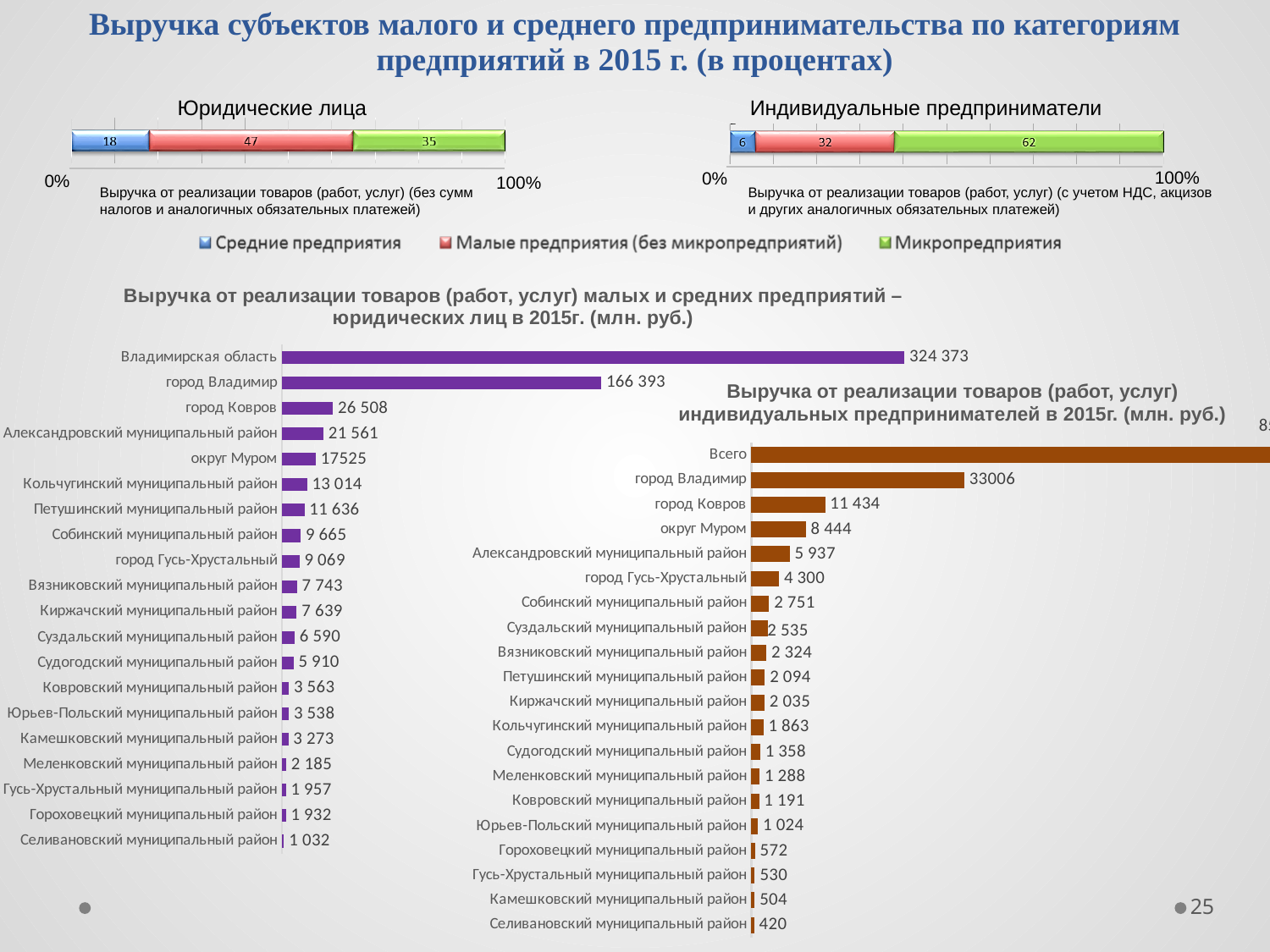
In the chart 'Выручка от реализации товаров (работ, услуг) индивидуальных предпринимателей в 2015г. (млн. руб.)', which is larger: Собинский муниципальный район or Петушинский муниципальный район? Собинский муниципальный район How many series does the shared legend of the two stacked bar charts list? 3 In the 'Юридические лица' stacked bar chart, what is the value for Малые предприятия (без микропредприятий)? 47 In the chart 'Выручка от реализации товаров (работ, услуг) малых и средних предприятий – юридических лиц в 2015г. (млн. руб.)', what is the value for город Владимир? 166 393 In the chart 'Выручка от реализации товаров (работ, услуг) малых и средних предприятий – юридических лиц в 2015г. (млн. руб.)', which category has the lowest value? Селивановский муниципальный район In the chart 'Выручка от реализации товаров (работ, услуг) малых и средних предприятий – юридических лиц в 2015г. (млн. руб.)', what is the difference between город Ковров and Александровский муниципальный район? 4 947 In the chart 'Выручка от реализации товаров (работ, услуг) индивидуальных предпринимателей в 2015г. (млн. руб.)', what is the value for Селивановский муниципальный район? 420 In the 'Индивидуальные предприниматели' stacked bar chart, what is the value for Микропредприятия? 62 What kind of chart is 'Выручка от реализации товаров (работ, услуг) индивидуальных предпринимателей в 2015г. (млн. руб.)'? Bar chart In the chart 'Выручка от реализации товаров (работ, услуг) индивидуальных предпринимателей в 2015г. (млн. руб.)', what is the value for город Ковров? 11 434 In the chart 'Выручка от реализации товаров (работ, услуг) малых и средних предприятий – юридических лиц в 2015г. (млн. руб.)', how many categories are shown? 20 In the 'Индивидуальные предприниматели' stacked bar chart, what is the value for Средние предприятия? 6